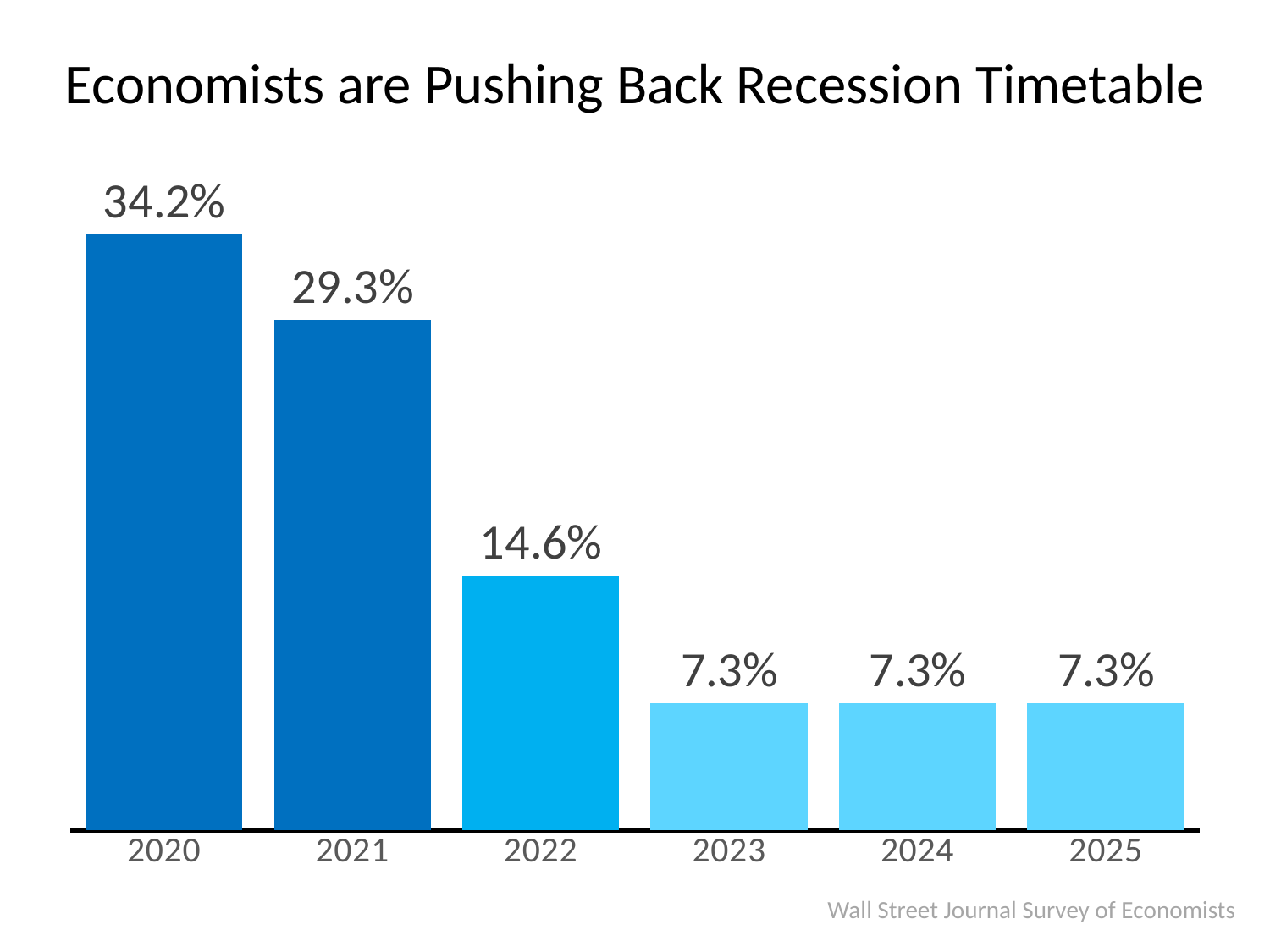
What is the difference between the values for 2020 and 2021? 4.9% What is the title of the chart? Economists are Pushing Back Recession Timetable What is the difference between the values for 2021 and 2022? 14.7% What is the value for 2022? 14.6% Which is larger, the value for 2021 or the value for 2022? 2021 What is the value for 2020? 34.2% What source is cited for the chart? Wall Street Journal Survey of Economists Do the values rise or fall from 2020 to 2022? Fall What is the value for 2024? 7.3% What kind of chart is shown on the slide? Bar chart Which year has the highest value? 2020 How many years are shown on the x axis? 6